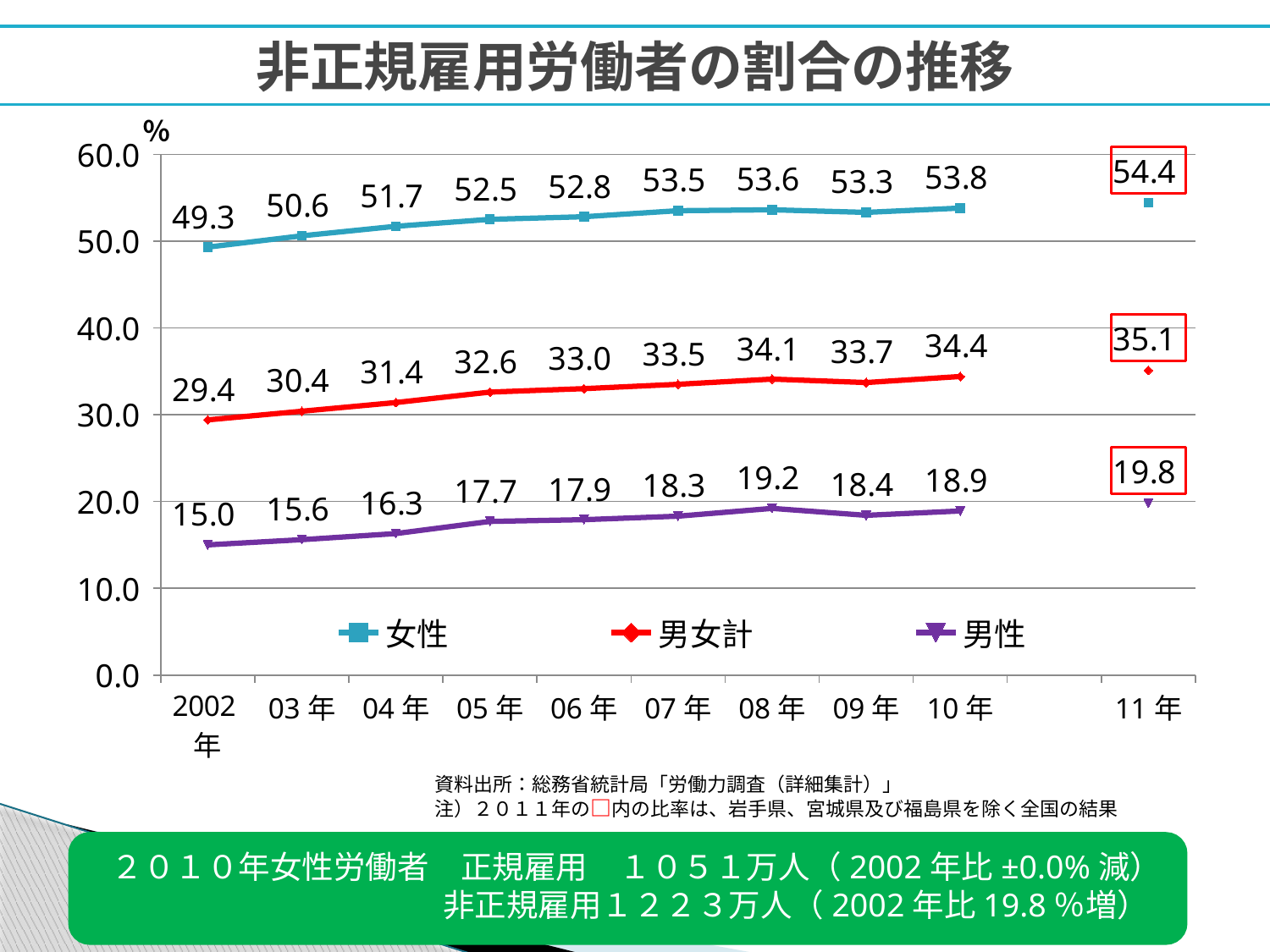
How many series does the legend list? 3 What is the difference between the 女性 value in 10年 and in 2002年? 4.5 Which is larger in 09年: the 男女計 value or the 男性 value? 男女計 What kind of chart is shown on the slide? line chart In which year is the 男性 series highest? 11年 What is the value for 男性 in 11年? 19.8 What is the value for 女性 in 2002年? 49.3 Is the value for 女性 in 05年 greater or less than 50.0? greater Does the 男女計 series generally rise or fall from 2002年 to 11年? rise What is the value for 男女計 in 08年? 34.1 What is the value for 女性 in 11年? 54.4 In which year is the 男女計 series lowest? 2002年